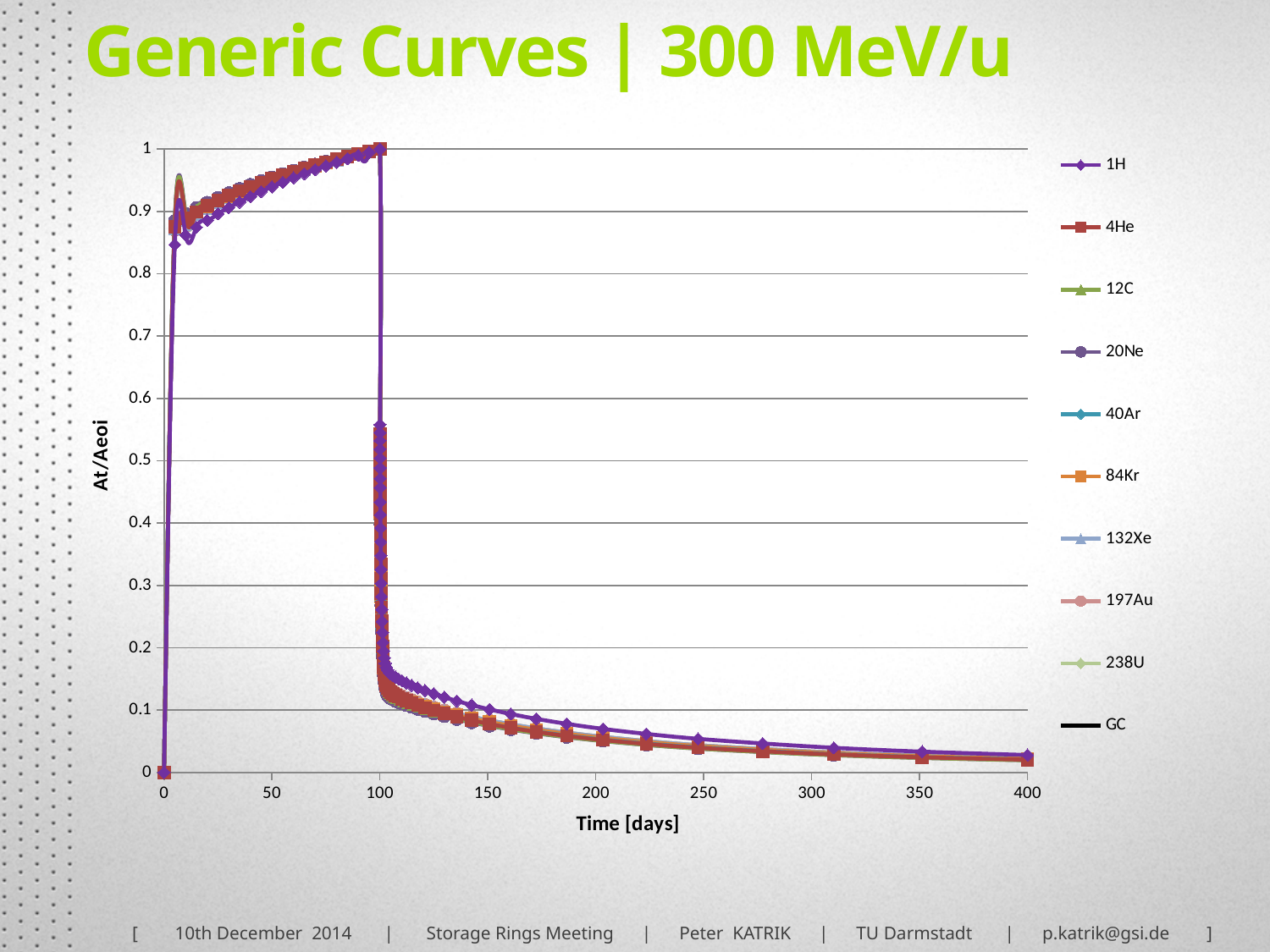
How many series does the legend list? 10 Is the value of the curves at 50 days greater or less than 0.9? greater What kind of chart is shown on the slide? line chart Is the value of the curves at 200 days greater or less than 0.2? less Is the value of the curves at 300 days greater or less than 0.1? less What is the title of the chart on the slide? Generic Curves | 300 MeV/u Do the curves rise or fall between 20 days and 100 days? rise Do the curves rise or fall between 150 days and 400 days? fall What is the label of the x axis? Time [days] What is the maximum value reached by the curves, at 100 days? 1 Which series is drawn as a plain black line without markers in the legend? GC